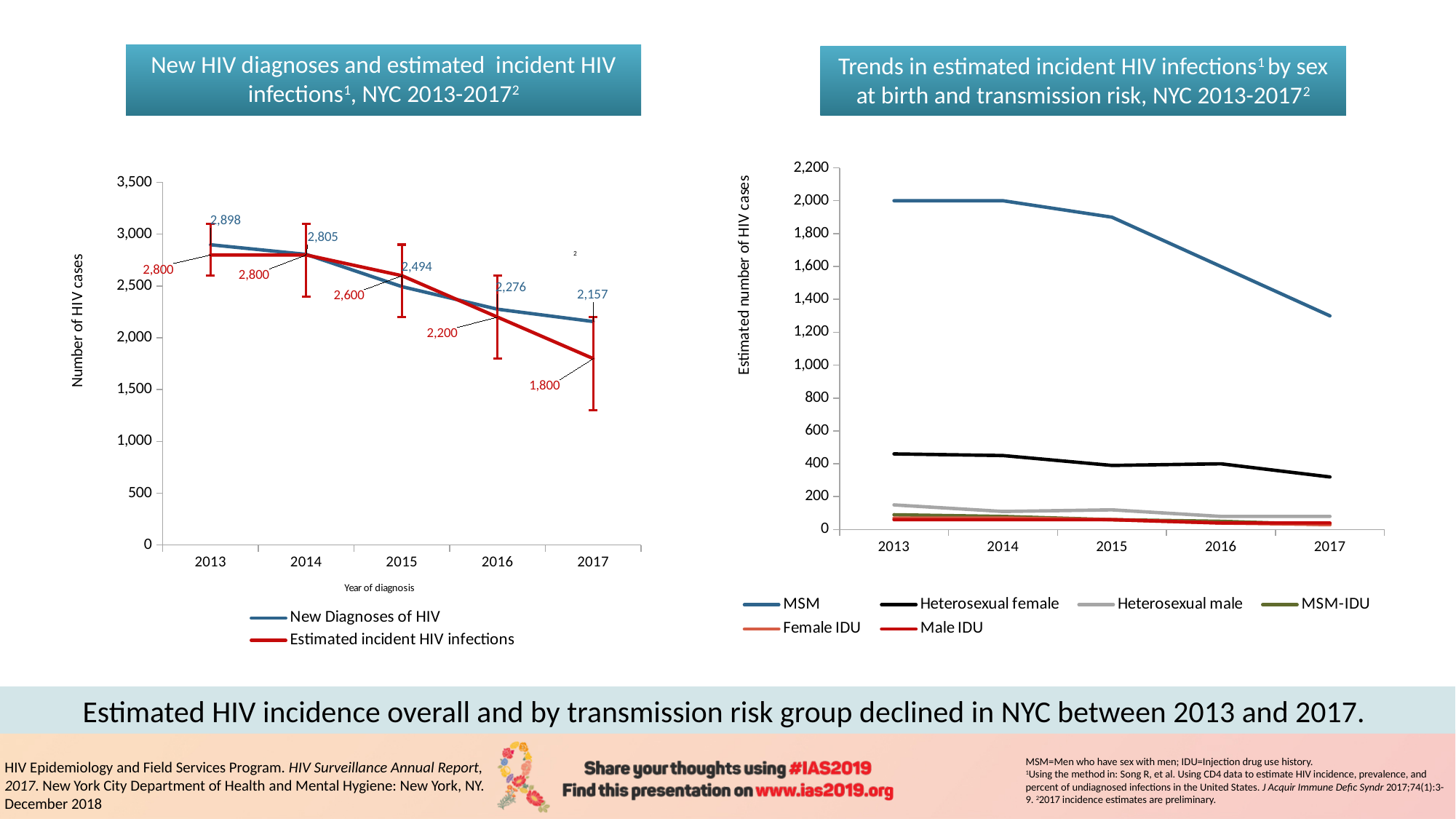
How many series does the legend of the right chart (Trends in estimated incident HIV infections by sex at birth and transmission risk) list? 6 In the left chart, what is the estimated number of incident HIV infections in 2017? 1,800 In the left chart, what is the difference between new diagnoses of HIV in 2013 and in 2017? 741 How many series does the legend of the left chart list? 2 In the left chart, which is larger in 2016: new diagnoses of HIV or estimated incident HIV infections? New Diagnoses of HIV In the right chart, which transmission risk group has the highest estimated number of HIV cases in every year? MSM What type of chart is the right chart? Line chart In the right chart, is the value for MSM in 2017 greater or less than 1,400? less In the left chart (New HIV diagnoses and estimated incident HIV infections), what is the number of new diagnoses of HIV in 2013? 2,898 In the left chart, what is the number of new diagnoses of HIV in 2015? 2,494 In the left chart, do the estimated incident HIV infections rise or fall from 2014 to 2017? Fall In the left chart, which year has the lowest number of new diagnoses of HIV? 2017